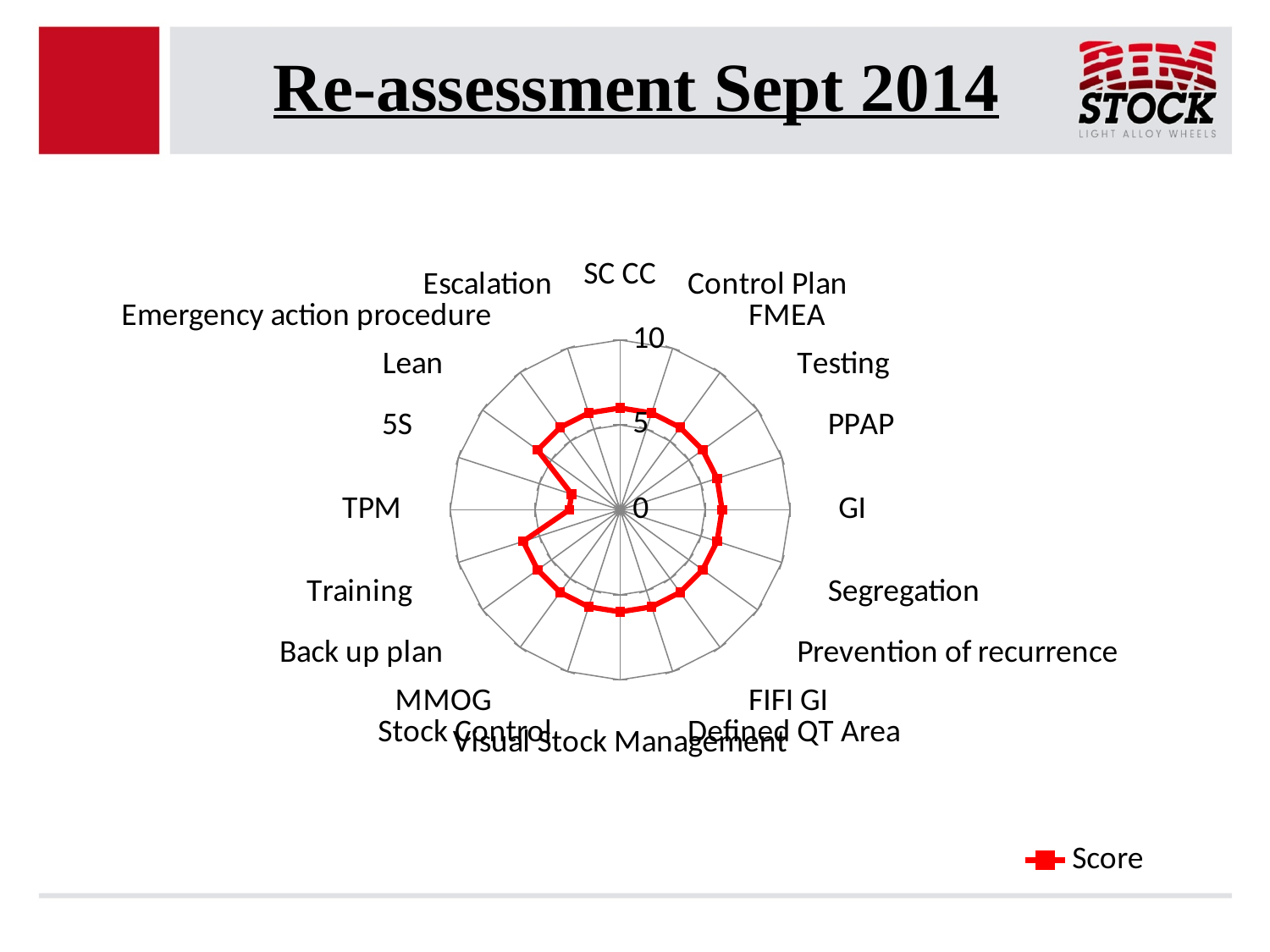
What kind of chart is shown on the slide? Radar chart Is the score for SC CC greater or less than 5? greater Which has the higher score, GI or TPM? GI How many series does the legend list? 1 Is the score for TPM greater or less than 5? less Is the score for GI greater or less than 5? greater What is the name of the series shown in the legend? Score How many categories are plotted on the radar chart? 20 Which category has the lowest score on the radar chart? TPM and 5S (tied) Which has the higher score, SC CC or 5S? SC CC What is the maximum value shown on the radar chart's axis? 10